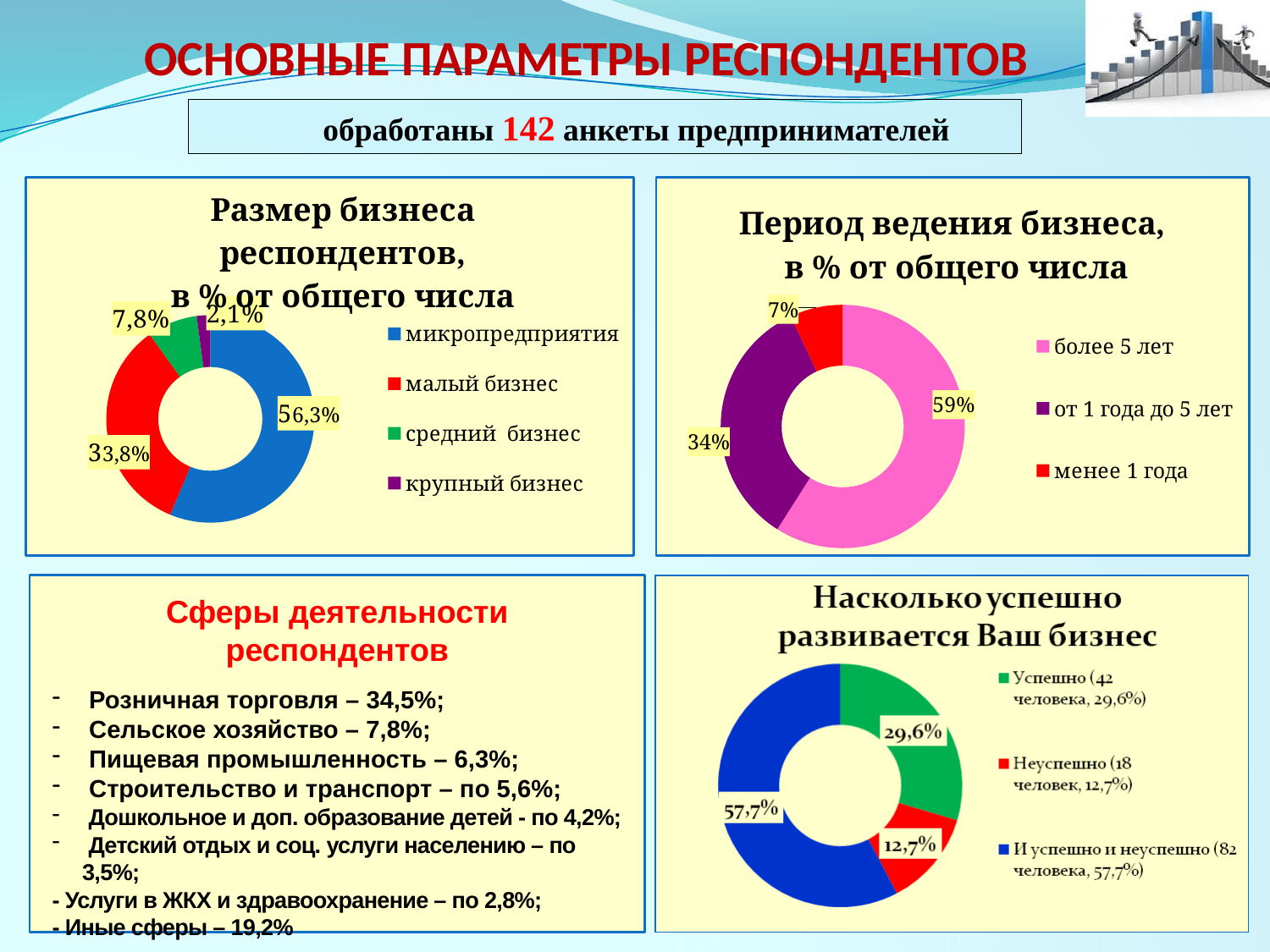
In the chart 'Насколько успешно развивается Ваш бизнес', which is larger: Успешно or И успешно и неуспешно? И успешно и неуспешно In the chart 'Размер бизнеса респондентов, в % от общего числа', how many categories does the legend list? 4 In the chart 'Период ведения бизнеса, в % от общего числа', what kind of chart is shown? doughnut chart In the chart 'Период ведения бизнеса, в % от общего числа', what is the value for более 5 лет? 59% In the chart 'Размер бизнеса респондентов, в % от общего числа', what is the difference between микропредприятия and малый бизнес? 22,5% In the chart 'Размер бизнеса респондентов, в % от общего числа', which category has the smallest share? крупный бизнес In the chart 'Период ведения бизнеса, в % от общего числа', which category has the largest share? более 5 лет In the chart 'Насколько успешно развивается Ваш бизнес', what is the value for Неуспешно? 12,7% In the chart 'Период ведения бизнеса, в % от общего числа', what is the value for менее 1 года? 7% In the chart 'Размер бизнеса респондентов, в % от общего числа', what is the value for малый бизнес? 33,8% In the chart 'Размер бизнеса респондентов, в % от общего числа', what is the value for микропредприятия? 56,3% In the chart 'Насколько успешно развивается Ваш бизнес', how many people answered Успешно according to the legend? 42